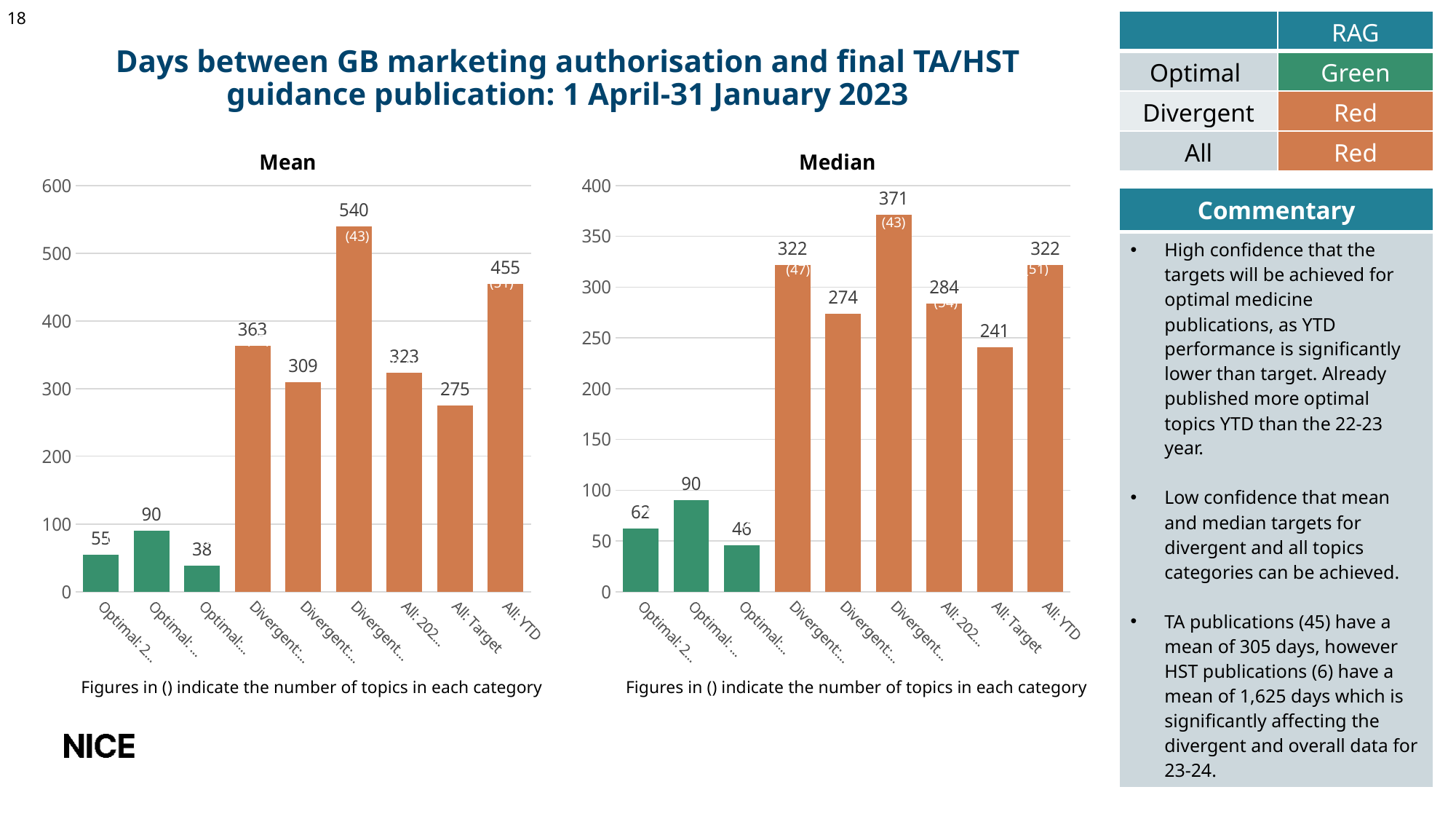
In the Mean chart, what is the value for All: Target? 275 In the Mean chart, what is the value for All: YTD? 455 In the Median chart, which is larger, All: YTD or All: Target? All: YTD What kind of chart is the Mean chart? Bar chart How many bars are plotted in the Median chart? 9 In the Mean chart, what is the highest value shown on any bar? 540 In the Median chart, what is the value for All: YTD? 322 In the Mean chart, what is the difference between All: YTD and All: Target? 180 In the Mean chart, what is the lowest value shown on any bar? 38 In the Median chart, what is the highest value shown on any bar? 371 In the Median chart, what is the value for All: Target? 241 In the Median chart, what is the lowest value shown on any bar? 46